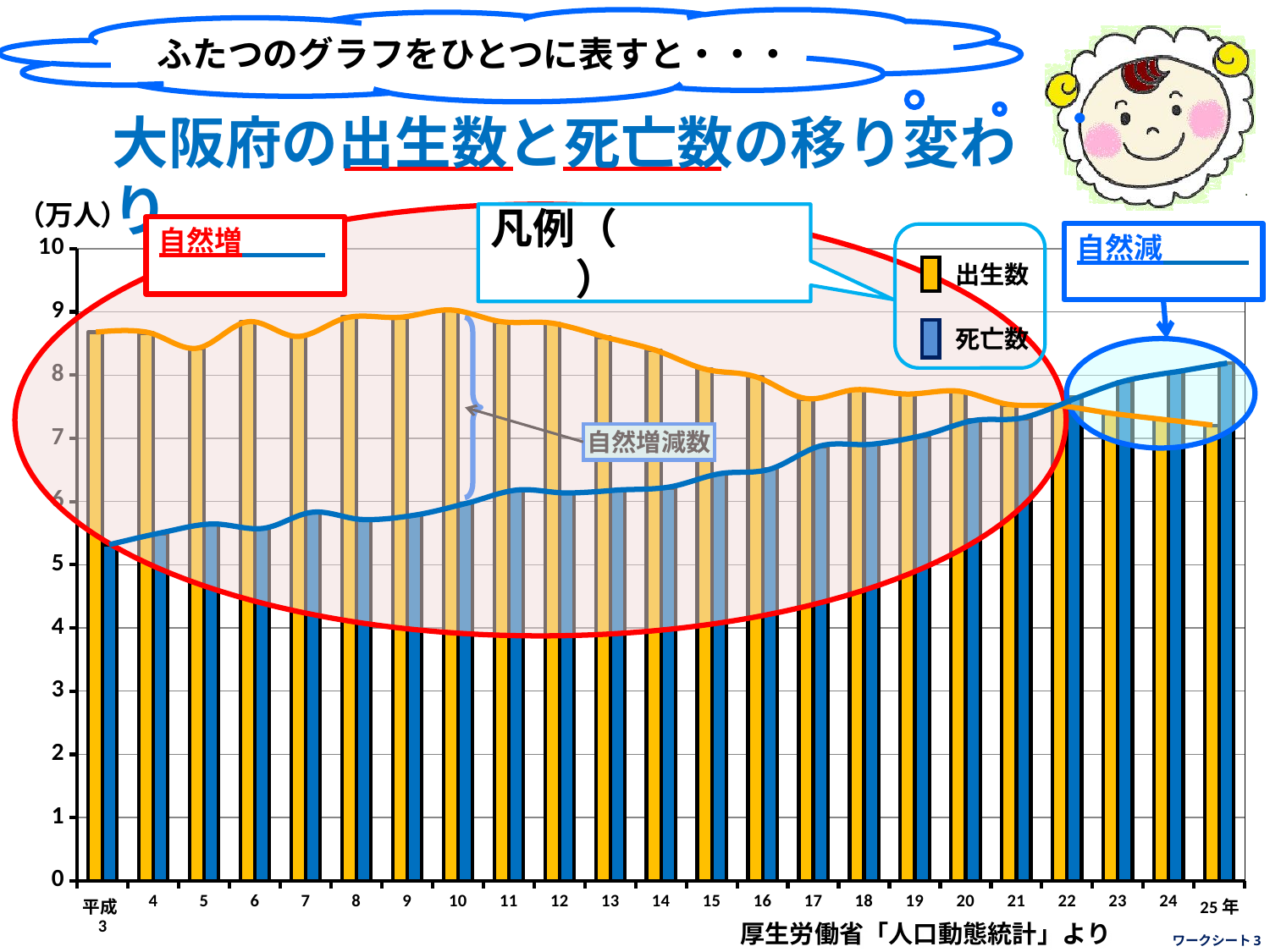
Is the value for 死亡数 in 平成3 greater or less than 6? less How many series does the legend list? 2 Does the 死亡数 series generally rise or fall from 平成3 to 平成25? rise What unit is shown on the y axis? 万人 Is the value for 出生数 in 平成3 greater or less than 8? greater How many years (categories) are shown on the x axis? 23 In 平成10, which is larger, 出生数 or 死亡数? 出生数 Is the value for 死亡数 in 平成15 greater or less than 6? greater In 平成25, which is larger, 出生数 or 死亡数? 死亡数 Which colour represents 出生数 in the legend? orange (yellow) What kind of chart is shown on the slide? bar chart